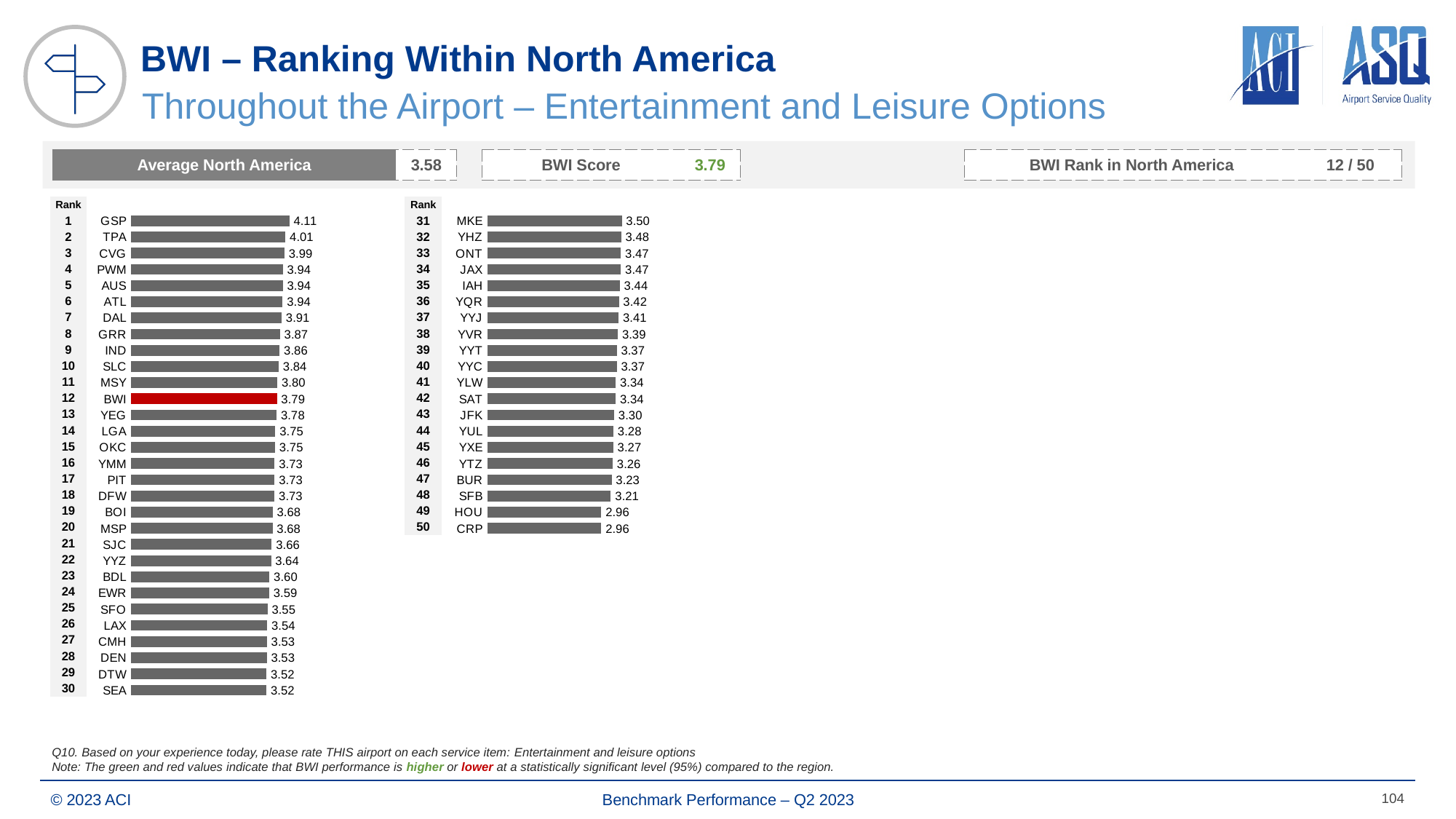
How many airports are plotted in the left chart (ranks 1-30)? 30 In the left chart (ranks 1-30), what is the difference between the scores of GSP and BWI? 0.32 In the left chart (ranks 1-30), what is the score for BWI? 3.79 How many airports are plotted in the right chart (ranks 31-50)? 20 In the right chart (ranks 31-50), what is the score for CRP? 2.96 In the left chart (ranks 1-30), which has the larger score, ATL or SEA? ATL In the right chart (ranks 31-50), what is the difference between the scores of MKE and CRP? 0.54 What kind of chart is used to show the airport scores on this slide? Bar chart In the left chart (ranks 1-30), what is the score for GSP? 4.11 In the right chart (ranks 31-50), which airport has the highest score? MKE In the left chart (ranks 1-30), which airport has the highest score? GSP In the left chart (ranks 1-30), which airport's bar is coloured red? BWI